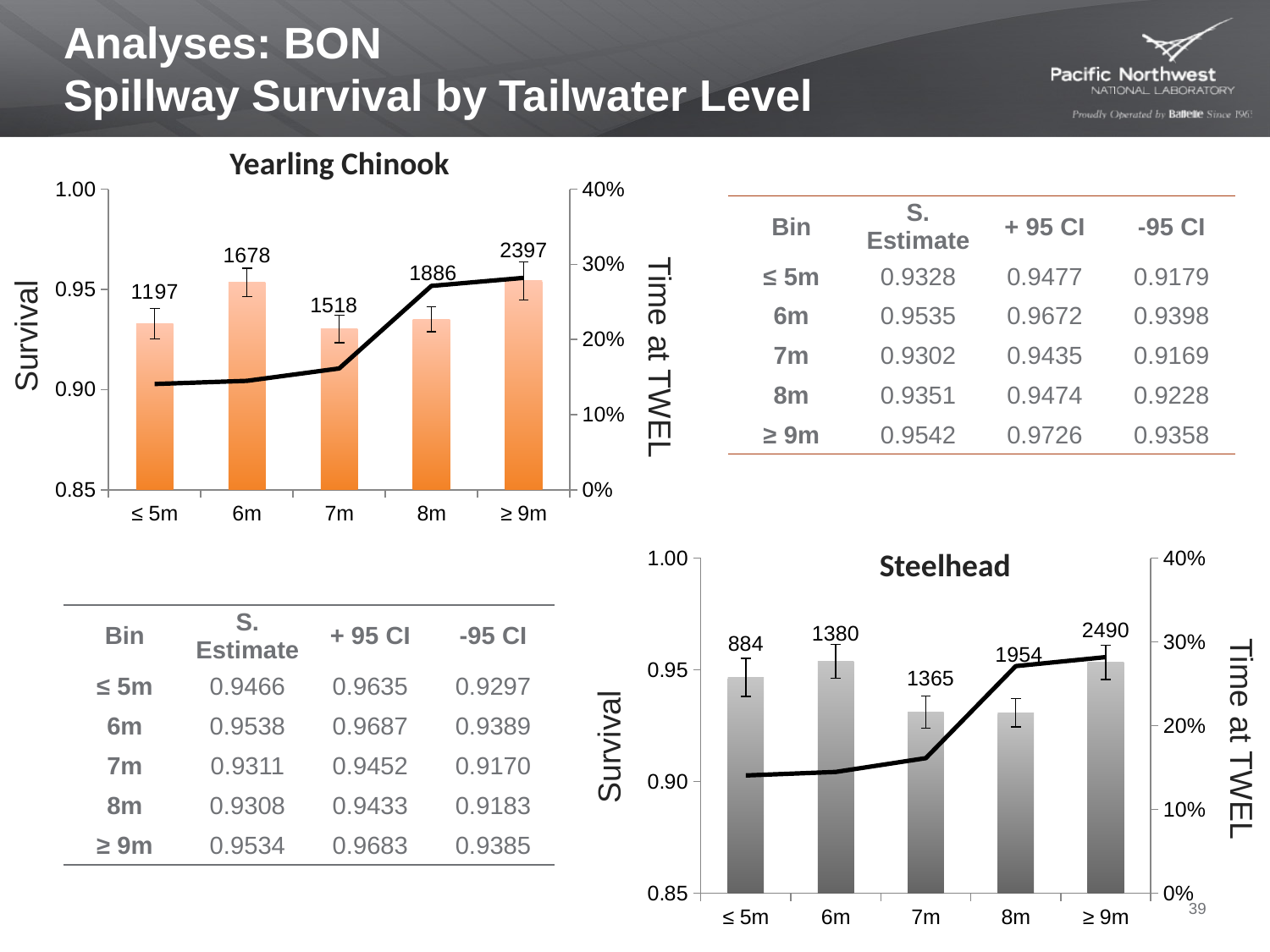
In the Steelhead chart, what is the difference between the labels printed above the ≥ 9m bar and the ≤ 5m bar? 1606 In the Yearling Chinook chart, what is the difference between the labels printed above the ≥ 9m bar and the ≤ 5m bar? 1200 In the Steelhead chart, which bar is taller, 6m or 7m? 6m In the Steelhead chart, which bin has the lowest printed label? ≤ 5m In the Yearling Chinook chart, which bin has the highest printed label? ≥ 9m In the Steelhead chart, what number is printed above the ≥ 9m bar? 2490 In the Yearling Chinook chart, does the Time at TWEL line rise or fall from ≤ 5m to ≥ 9m? rise In the Yearling Chinook chart, what number is printed above the 6m bar? 1678 How many tailwater level bins are shown on the x axis of the Steelhead chart? 5 In the Steelhead chart, is the Time at TWEL line value at ≤ 5m greater or less than 20%? less In the Yearling Chinook chart, is the survival bar for ≤ 5m greater or less than 0.90? greater What kind of chart is the Yearling Chinook chart? combination bar and line chart